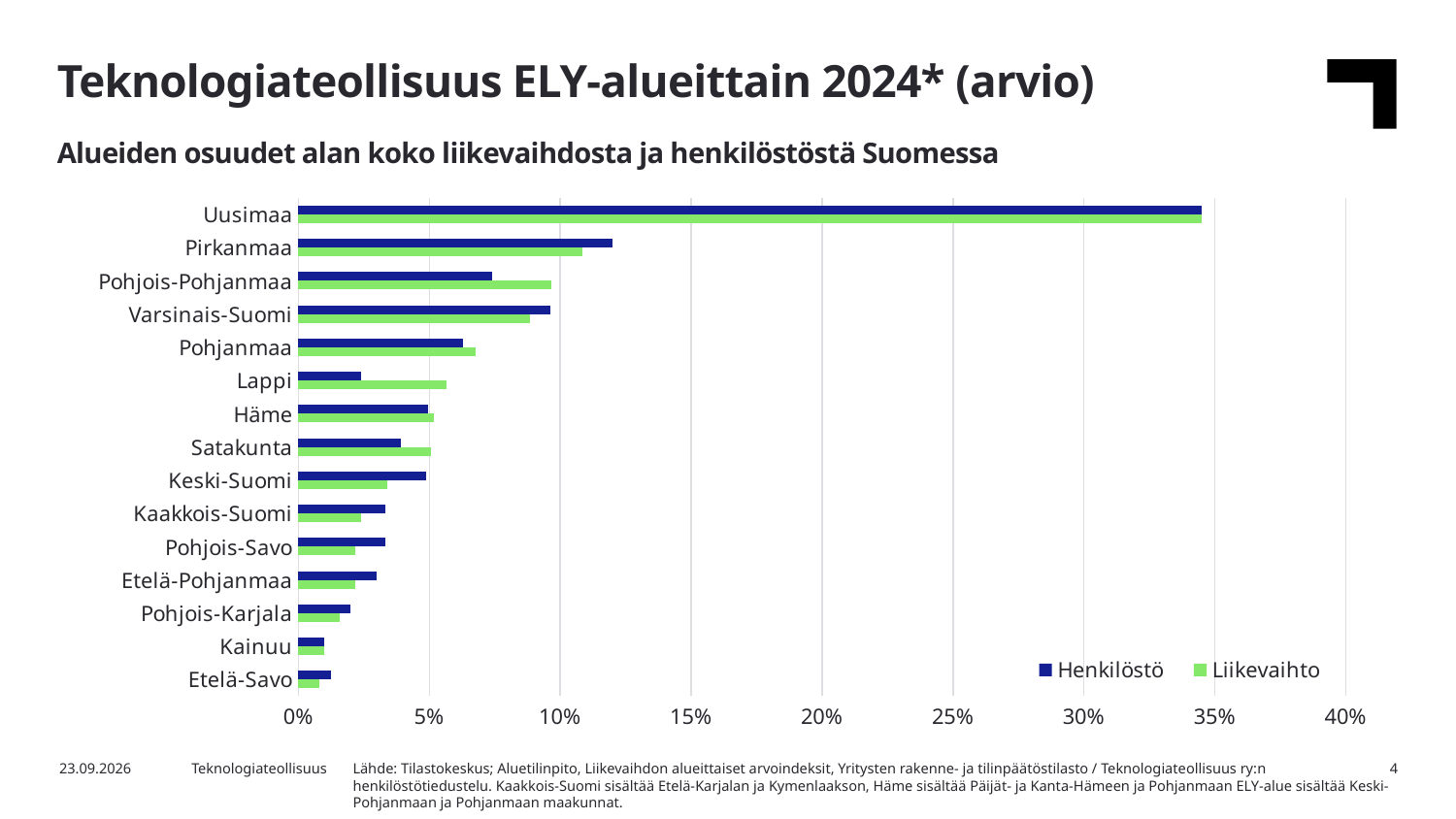
Is the Henkilöstö value for Pirkanmaa greater or less than 10%? greater How many series does the legend list? 2 For Pohjois-Pohjanmaa, which is larger: Henkilöstö or Liikevaihto? Liikevaihto Is the Henkilöstö value for Uusimaa greater or less than 30%? greater Which region has the highest Liikevaihto share? Uusimaa Is the Henkilöstö value for Lappi greater or less than 5%? less Which region has the highest Henkilöstö share? Uusimaa What is the title of the chart on the slide? Teknologiateollisuus ELY-alueittain 2024* (arvio) For Keski-Suomi, which is larger: Henkilöstö or Liikevaihto? Henkilöstö How many regions (categories) are shown on the chart? 15 What kind of chart is shown on the slide? Bar chart